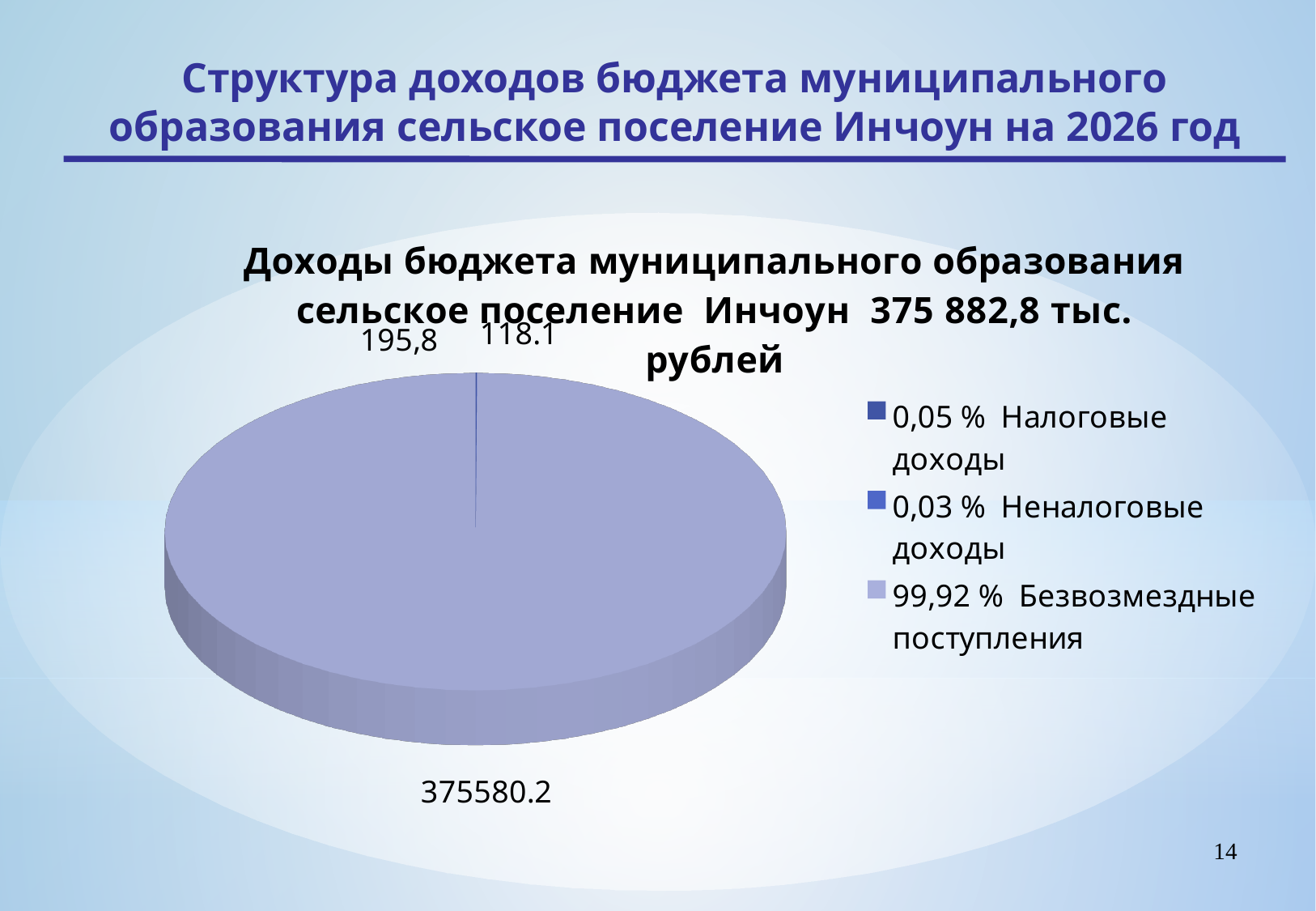
What is the data label value for Безвозмездные поступления? 375580.2 What share of the pie does Налоговые доходы account for? 0,05 % Which is larger, the share for Налоговые доходы or the share for Неналоговые доходы? Налоговые доходы Which category has the smallest slice of the pie? Неналоговые доходы What share of the pie does Безвозмездные поступления account for? 99,92 % How many entries does the legend of the pie chart list? 3 How many slices does the pie chart have? 3 What kind of chart is shown on the slide? pie chart What share of the pie does Неналоговые доходы account for? 0,03 % Which category has the largest slice of the pie? Безвозмездные поступления What colour is the largest slice of the pie? light purple What total amount of budget revenue is stated in the chart title? 375 882,8 тыс. рублей